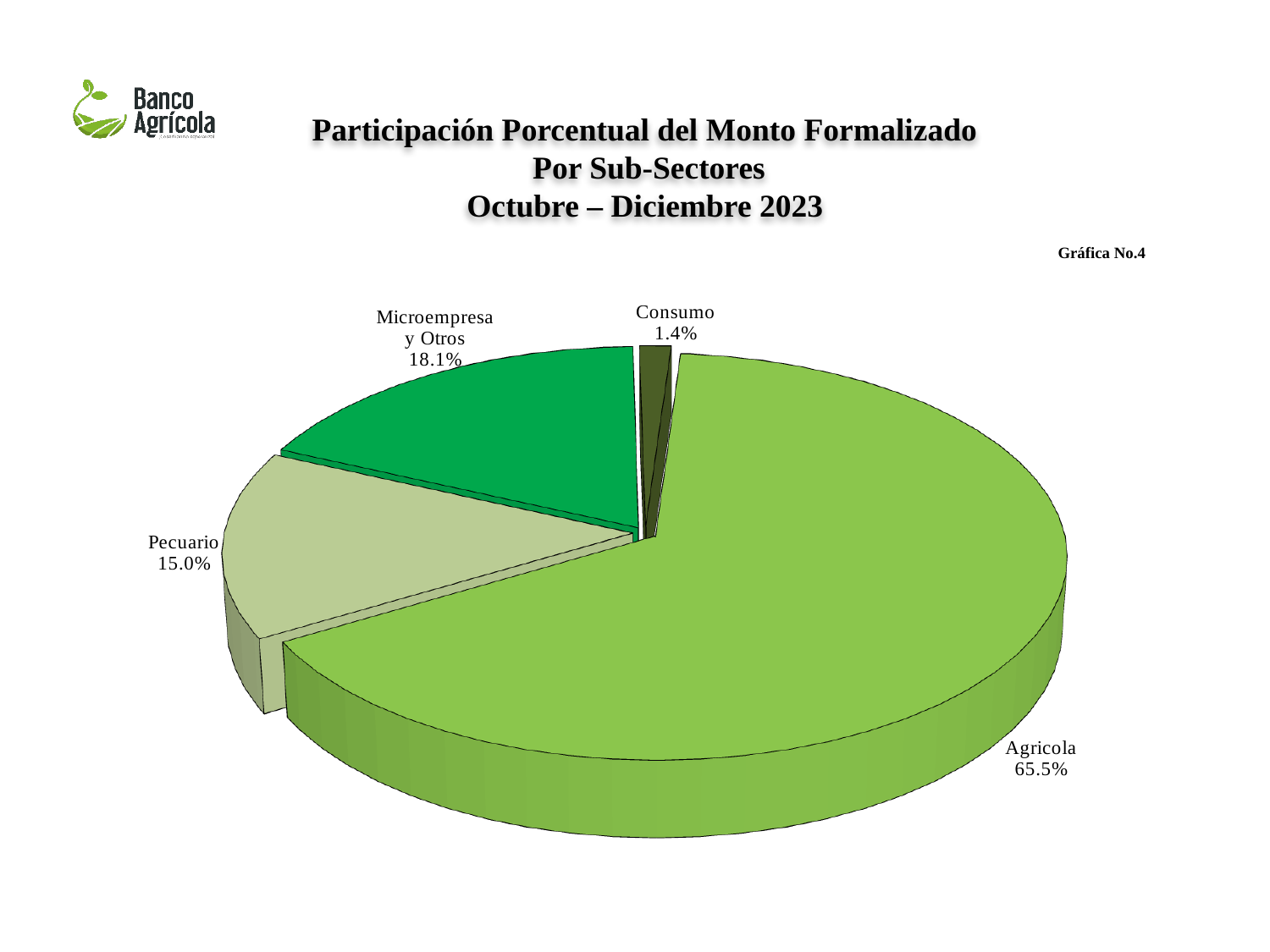
What type of chart is shown on the slide? Pie chart What is the share for Pecuario? 15.0% What period does the chart title say the data covers? Octubre – Diciembre 2023 How many sub-sectors are shown in the pie chart? 4 Which is larger, the share for Microempresa y Otros or the share for Pecuario? Microempresa y Otros What is the difference in percentage points between the Agricola share and the Pecuario share? 50.5 Which sub-sector has the smallest share? Consumo Which sub-sector has the largest share? Agricola What is the share for Consumo? 1.4% What is the difference in percentage points between the Microempresa y Otros share and the Consumo share? 16.7 What is the share for Microempresa y Otros? 18.1% What is the share for Agricola? 65.5%